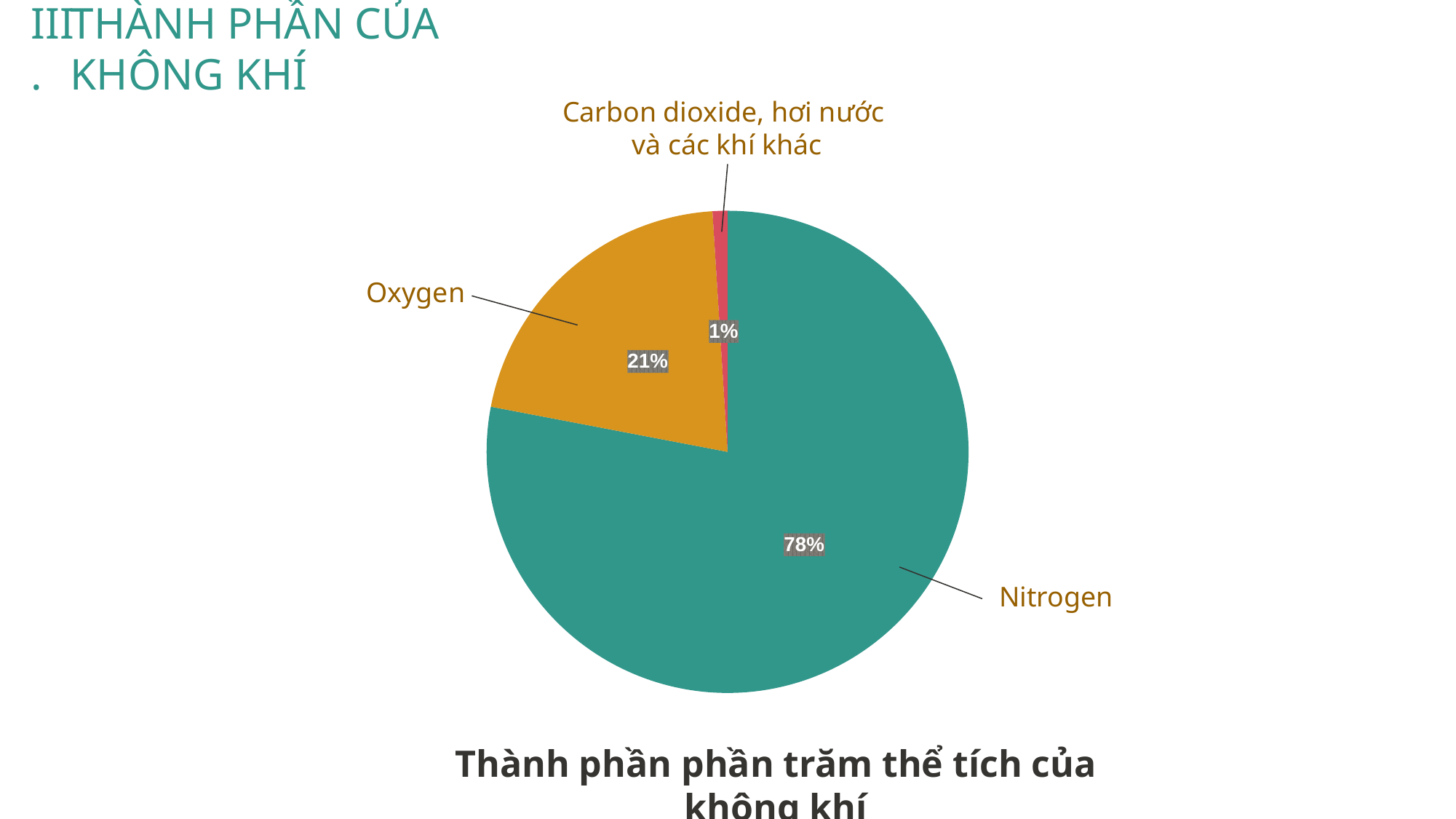
What colour is the Oxygen slice of the pie? orange What is the difference in percentage points between the Nitrogen slice and the Oxygen slice? 57 What is the title of the pie chart? Thành phần phần trăm thể tích của không khí Which slice of the pie is the largest? Nitrogen How many slices does the pie chart have? 3 Which slice of the pie is the smallest? Carbon dioxide, hơi nước và các khí khác What is the combined percentage of the Oxygen slice and the 'Carbon dioxide, hơi nước và các khí khác' slice? 22% What percentage of the pie does Oxygen account for? 21% What percentage of the pie does Nitrogen account for? 78% Which is larger, the Oxygen slice or the 'Carbon dioxide, hơi nước và các khí khác' slice? Oxygen What type of chart is shown on the slide? pie chart What percentage is shown for the slice labelled 'Carbon dioxide, hơi nước và các khí khác'? 1%